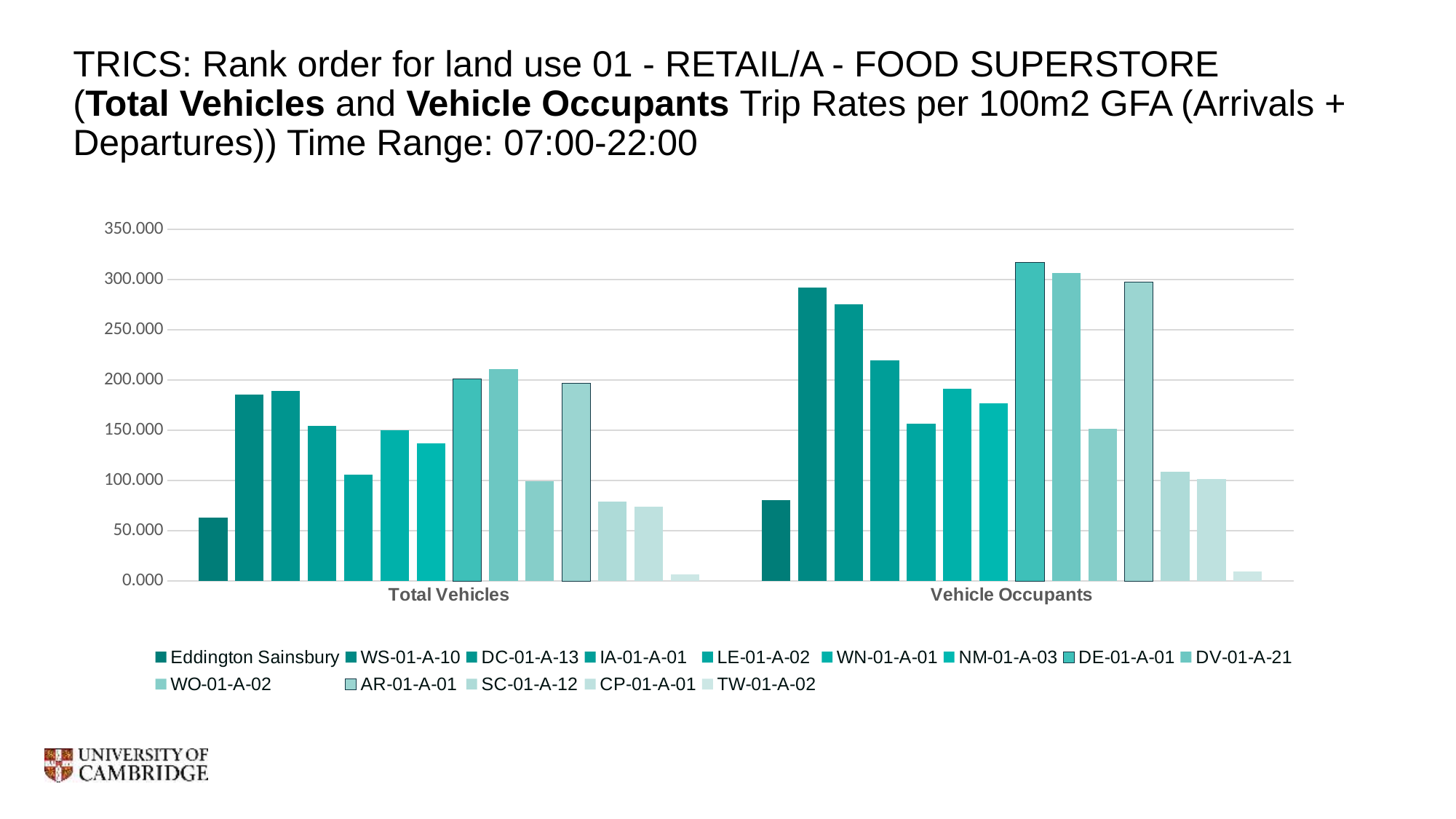
Which series has the lowest value in the Total Vehicles category? TW-01-A-02 How many series does the chart legend list? 14 What is the highest value shown on the y axis of the chart? 350.000 Is the Eddington Sainsbury value larger for Total Vehicles or for Vehicle Occupants? Vehicle Occupants Which series has the lowest value in the Vehicle Occupants category? TW-01-A-02 Which series is listed first in the chart legend? Eddington Sainsbury Is the Total Vehicles value for Eddington Sainsbury greater or less than 100.000? less What kind of chart is shown on the slide? bar chart How many categories are shown on the x axis of the chart? 2 Is the Vehicle Occupants value for Eddington Sainsbury greater or less than 100.000? less Is the Total Vehicles value for Eddington Sainsbury greater or less than 50.000? greater